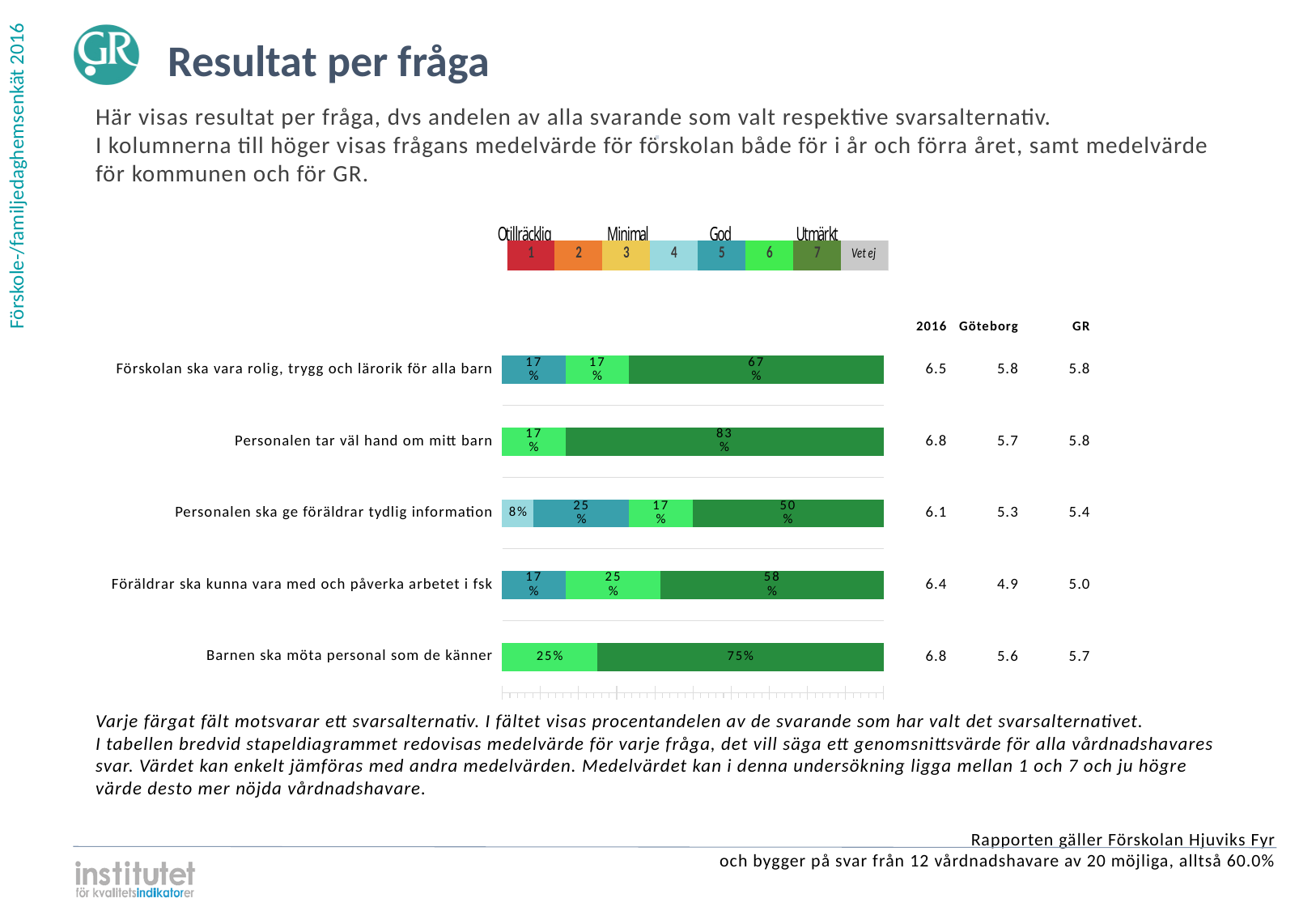
How many questions (categories) are shown in the bar chart? 5 Which is larger: the light green (6) share for 'Föräldrar ska kunna vara med och påverka arbetet i fsk' or for 'Förskolan ska vara rolig, trygg och lärorik för alla barn'? Föräldrar ska kunna vara med och påverka arbetet i fsk What percentage of respondents chose answer 7 (dark green) for 'Personalen ska ge föräldrar tydlig information'? 50% What is the Göteborg mean value shown for 'Personalen ska ge föräldrar tydlig information'? 5.3 What kind of chart is used to show the results per question? Stacked bar chart What percentage of respondents chose the highest answer (7, dark green) for 'Personalen tar väl hand om mitt barn'? 83% Which question has the largest share of respondents choosing answer 7 (dark green)? Personalen tar väl hand om mitt barn How many answer categories does the legend above the chart list? 8 What is the total of the segments in the bar for 'Barnen ska möta personal som de känner'? 100% What is the 2016 mean value shown for 'Föräldrar ska kunna vara med och påverka arbetet i fsk'? 6.4 Which question has the smallest share of respondents choosing answer 7 (dark green)? Personalen ska ge föräldrar tydlig information What is the difference between the dark green (7) shares for 'Barnen ska möta personal som de känner' and 'Föräldrar ska kunna vara med och påverka arbetet i fsk'? 17 percentage points